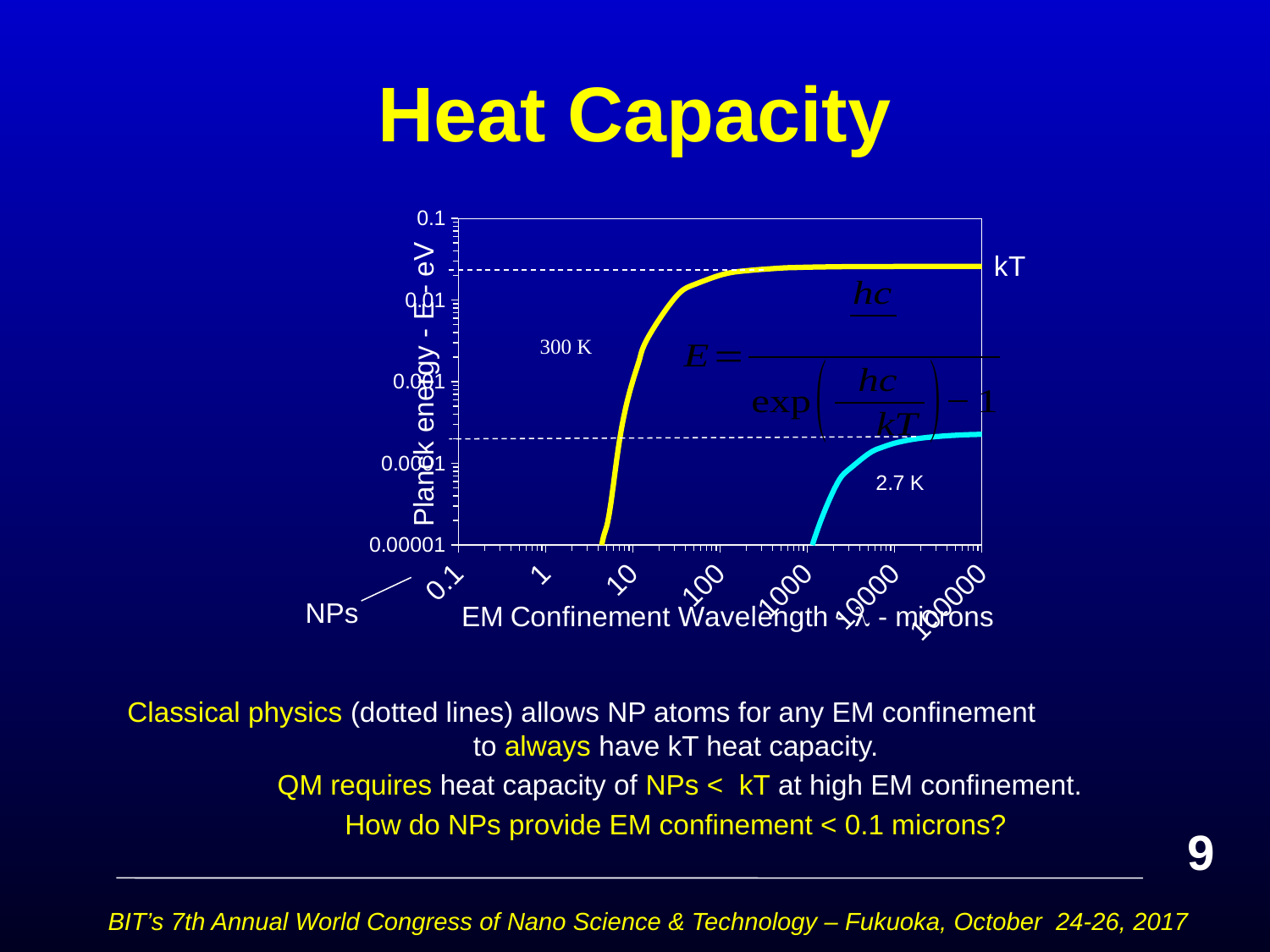
How many tick labels are shown on the x axis? 7 Which curve lies higher on the chart, the 300 K curve or the 2.7 K curve? 300 K At a wavelength of 10000 microns, which curve has the higher Planck energy, 300 K or 2.7 K? 300 K What kind of chart is shown on the slide? line chart How many temperature curves are plotted on the chart? 2 Is the plateau value of the 300 K curve at 10000 microns greater or less than 0.01 eV? greater Is the plateau value of the 2.7 K curve at 10000 microns greater or less than 0.001 eV? less What label is given to the horizontal dotted lines on the chart? kT What is the label of the x axis of the chart? EM Confinement Wavelength λ - microns Does the Planck energy of the 300 K curve rise or fall as the EM confinement wavelength increases? rise Is the plateau value of the 2.7 K curve at 10000 microns greater or less than 0.0001 eV? greater What is the highest tick value shown on the x axis? 100000